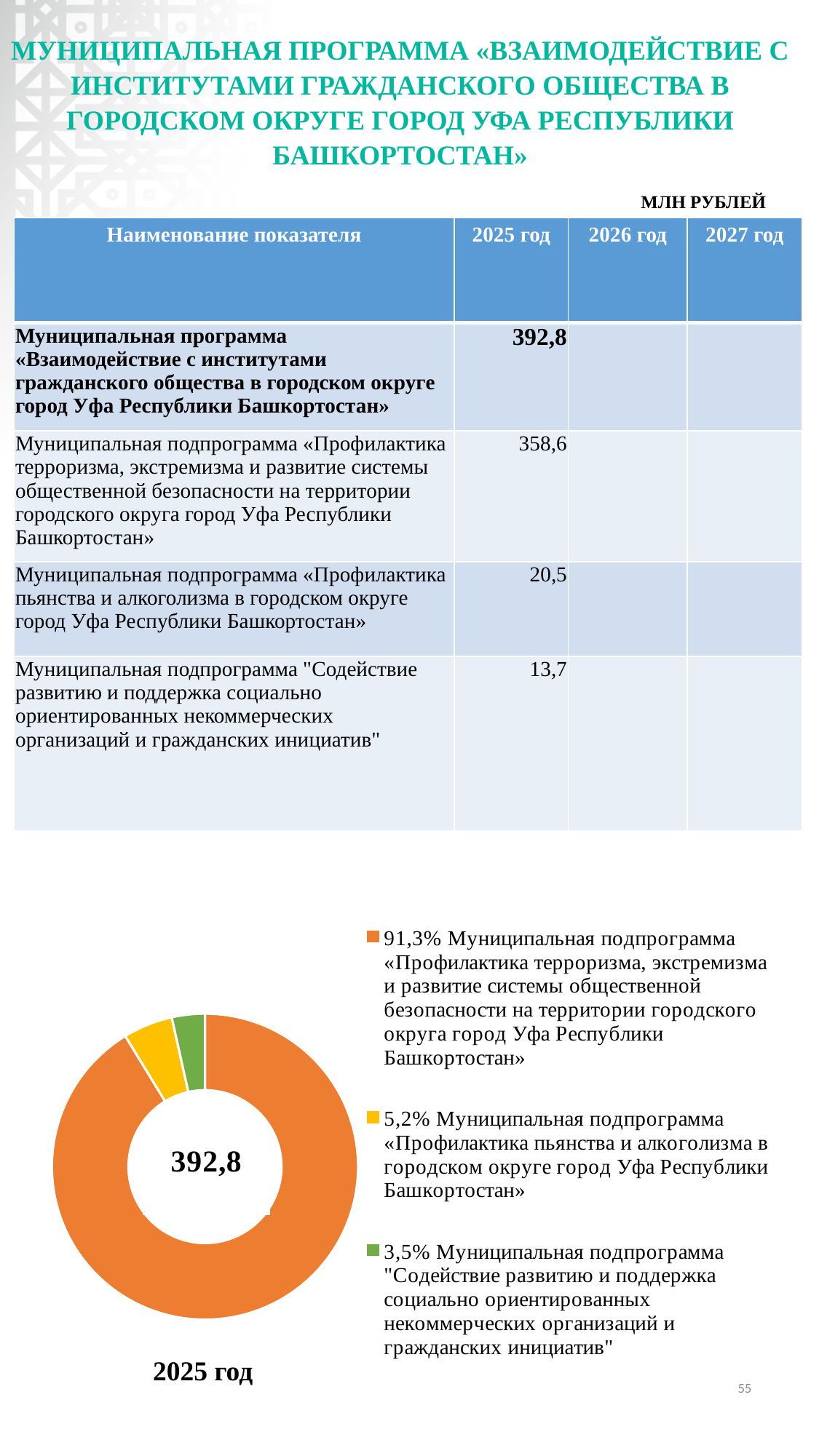
What share of the doughnut chart does the subprogramme "Содействие развитию и поддержка социально ориентированных некоммерческих организаций и гражданских инициатив" take? 3,5% Which slice of the doughnut chart is the smallest? Муниципальная подпрограмма "Содействие развитию и поддержка социально ориентированных некоммерческих организаций и гражданских инициатив" (3,5%) Which is larger in the doughnut chart: the share for «Профилактика пьянства и алкоголизма...» or the share for "Содействие развитию и поддержка социально ориентированных некоммерческих организаций..."? «Профилактика пьянства и алкоголизма...» (5,2%) Which slice of the doughnut chart is the largest? Муниципальная подпрограмма «Профилактика терроризма, экстремизма и развитие системы общественной безопасности на территории городского округа город Уфа Республики Башкортостан» (91,3%) What is the difference in percentage points between the 5,2% slice and the 3,5% slice of the doughnut chart? 1,7 percentage points What share of the doughnut chart does the subprogramme «Профилактика пьянства и алкоголизма в городском округе город Уфа Республики Башкортостан» take? 5,2% What share of the doughnut chart does the subprogramme «Профилактика терроризма, экстремизма и развитие системы общественной безопасности...» take? 91,3% What kind of chart is shown on the slide? Doughnut (pie) chart How many entries does the legend of the doughnut chart list? 3 How many slices does the doughnut chart have? 3 What colour is the largest slice of the doughnut chart? Orange What total value is printed in the centre of the doughnut chart? 392,8